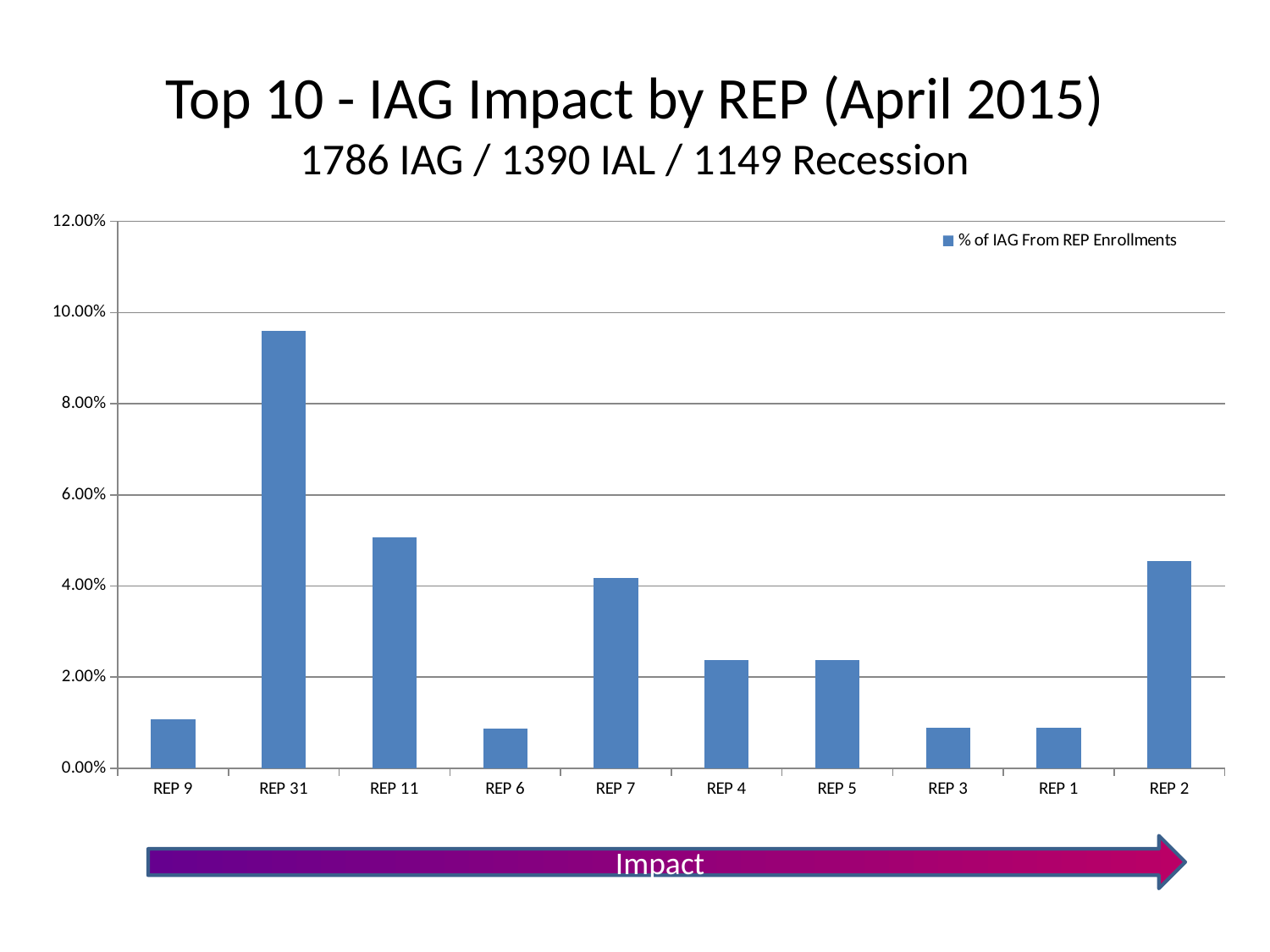
Is the value for REP 6 greater or less than 2.00%? less How many series does the legend list? 1 Which is larger, the value for REP 7 or the value for REP 4? REP 7 Is the value for REP 31 greater or less than 8.00%? greater What kind of chart is shown on the slide? bar chart How many REP categories are plotted on the x axis? 10 Which REP has the highest % of IAG From REP Enrollments? REP 31 Is the value for REP 11 greater or less than 4.00%? greater Which is larger, the value for REP 31 or the value for REP 11? REP 31 What is the series name shown in the legend? % of IAG From REP Enrollments